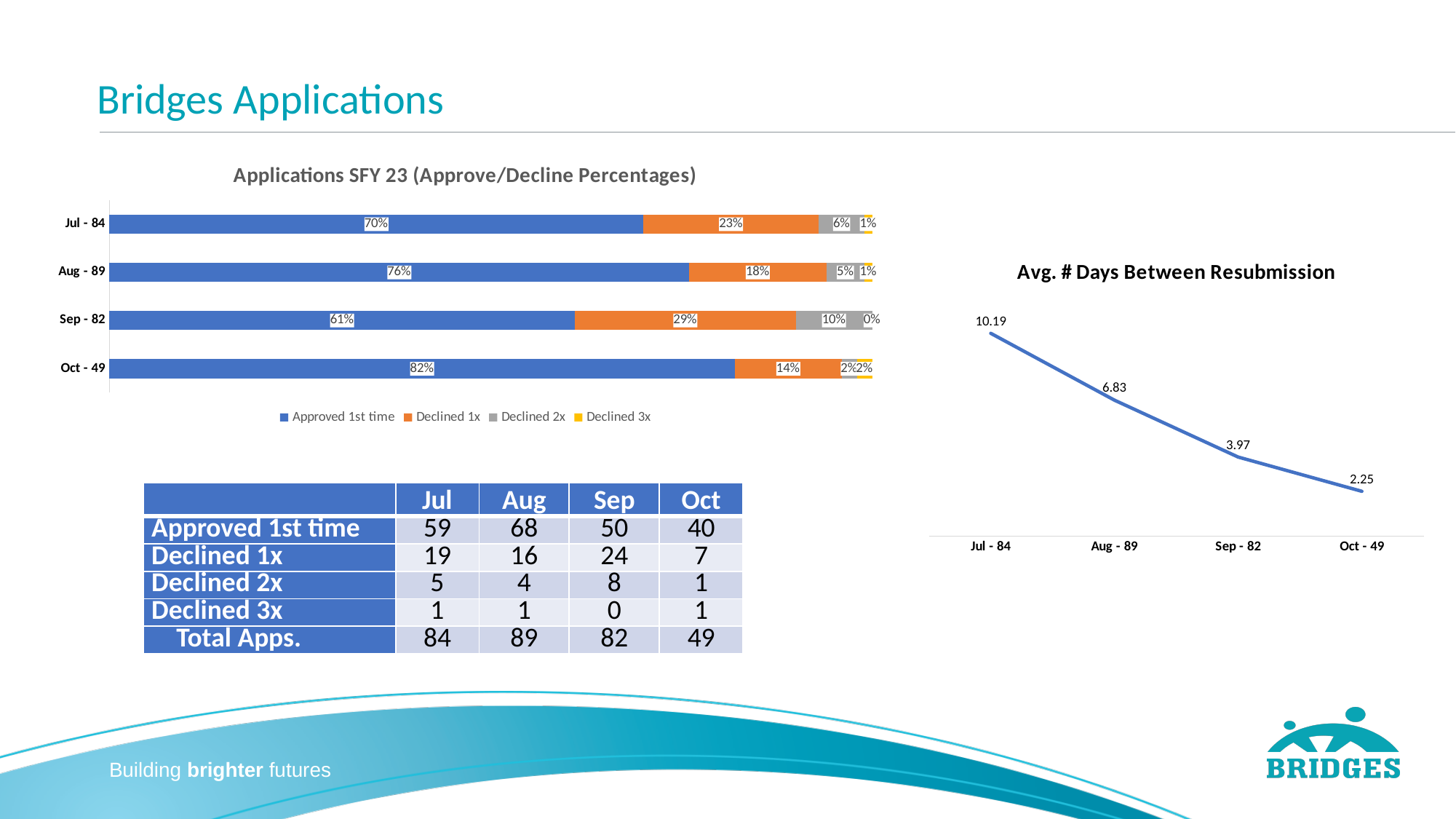
In the 'Applications SFY 23 (Approve/Decline Percentages)' chart, what percentage was Declined 1x for Sep - 82? 29% In the 'Applications SFY 23 (Approve/Decline Percentages)' chart, what is the difference between the Declined 1x percentages for Jul - 84 and Aug - 89? 5% How many data points are plotted in the 'Avg. # Days Between Resubmission' chart? 4 In the 'Avg. # Days Between Resubmission' chart, do the values rise or fall from Jul - 84 to Oct - 49? Fall In the 'Applications SFY 23 (Approve/Decline Percentages)' chart, how many series does the legend list? 4 In the 'Applications SFY 23 (Approve/Decline Percentages)' chart, which month has the highest Approved 1st time percentage? Oct - 49 In the 'Applications SFY 23 (Approve/Decline Percentages)' chart, which month has the lowest Approved 1st time percentage? Sep - 82 In the 'Applications SFY 23 (Approve/Decline Percentages)' chart, what percentage was Approved 1st time for Oct - 49? 82% In the 'Avg. # Days Between Resubmission' chart, what is the difference between the values for Jul - 84 and Oct - 49? 7.94 In the 'Avg. # Days Between Resubmission' chart, what is the value for Aug - 89? 6.83 In the 'Avg. # Days Between Resubmission' chart, which month has the lowest value? Oct - 49 What kind of chart is 'Applications SFY 23 (Approve/Decline Percentages)'? Stacked bar chart